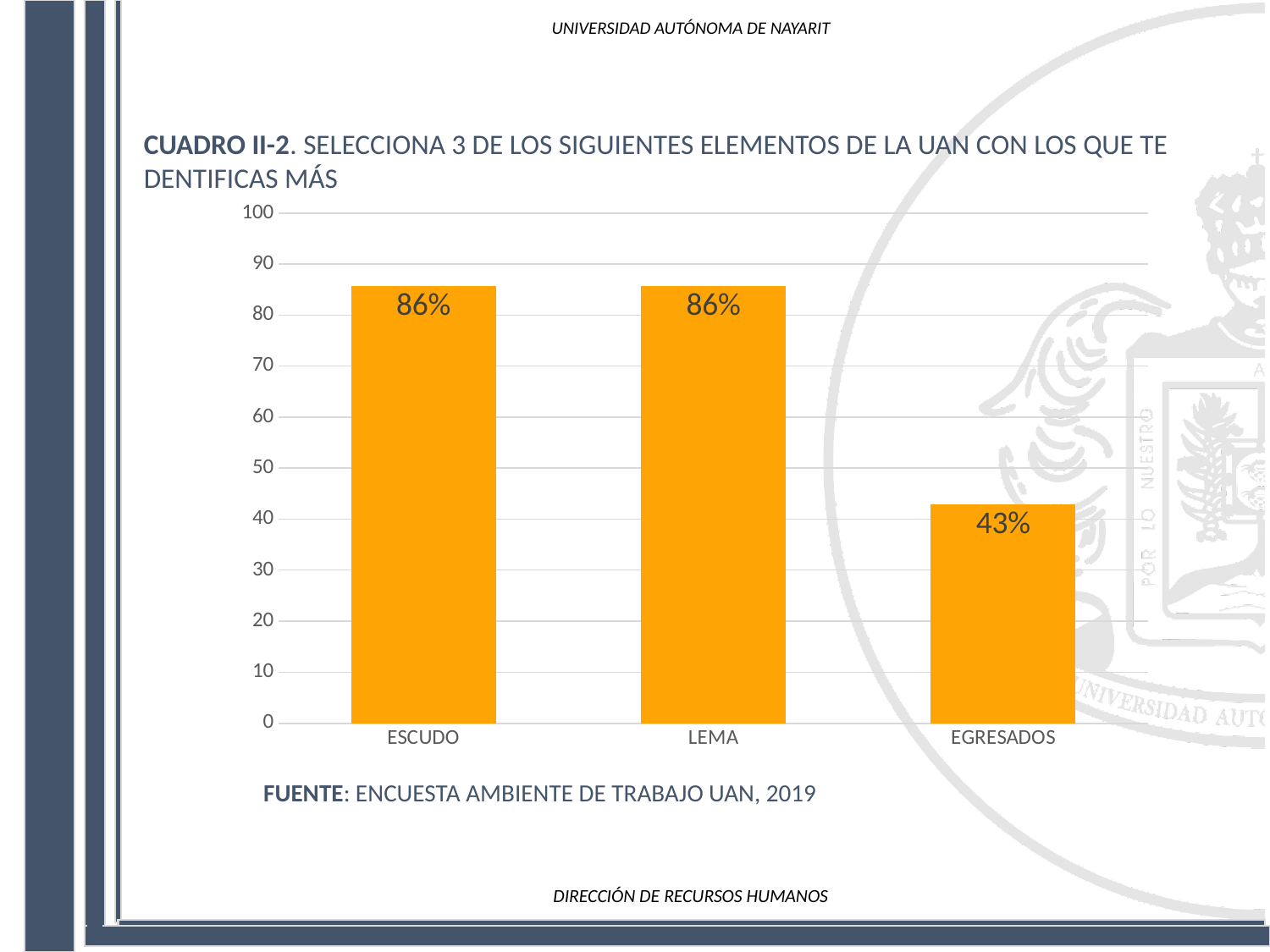
Is the value for EGRESADOS greater or less than 50? less Which category has the lowest value? EGRESADOS What is the difference between the values for LEMA and EGRESADOS? 43% How many categories are shown on the x axis? 3 Is the value for ESCUDO greater or less than 80? greater What source is cited below the chart? ENCUESTA AMBIENTE DE TRABAJO UAN, 2019 What kind of chart is shown on the slide? bar chart What is the value for ESCUDO? 86% What is the value for LEMA? 86% What is the value for EGRESADOS? 43% What is the difference between the values for ESCUDO and EGRESADOS? 43% Which is larger, the value for LEMA or the value for EGRESADOS? LEMA